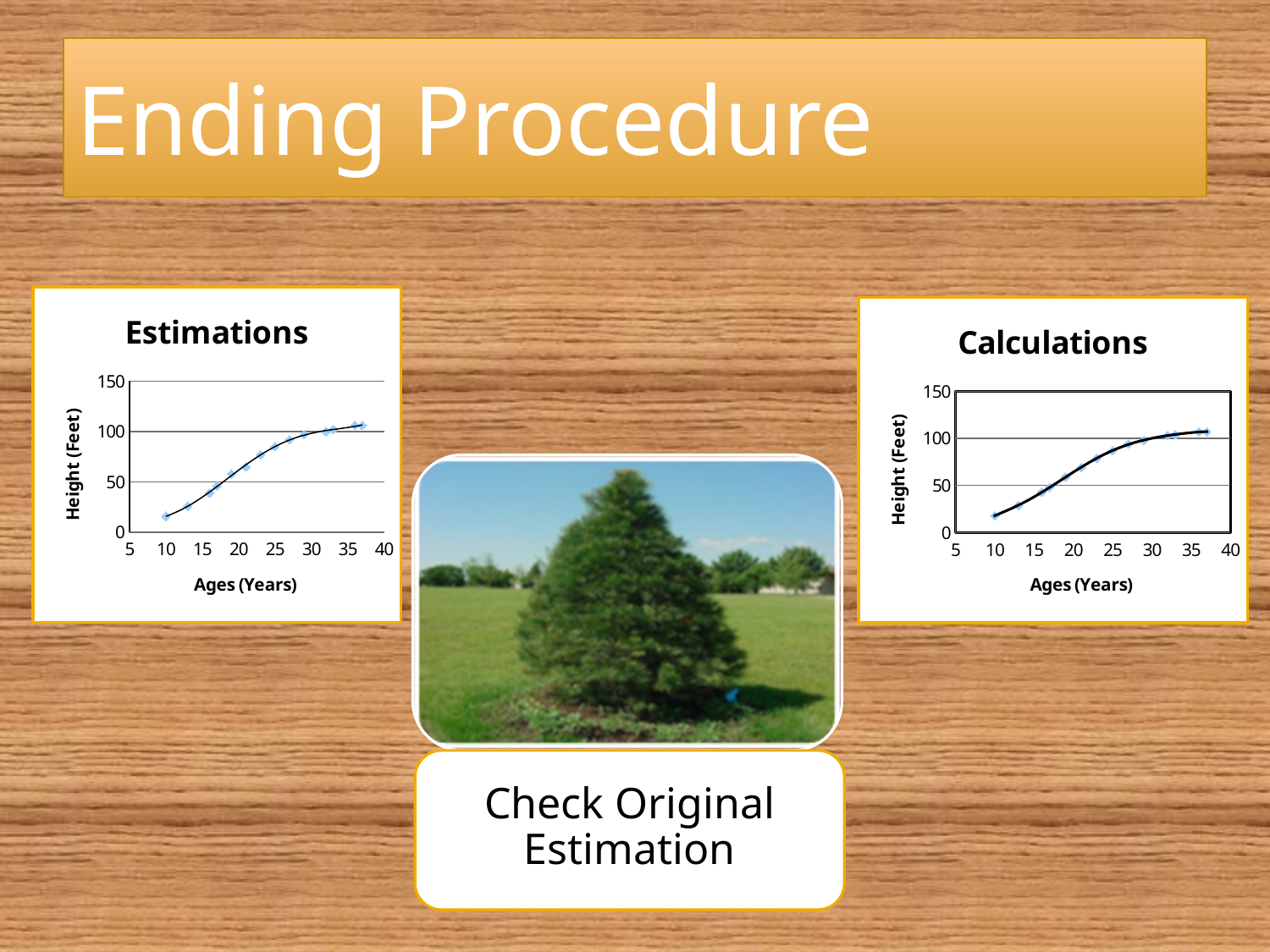
What kind of chart is the Estimations chart? scatter chart with a trend line In the Estimations chart, is the height at age 20 greater or less than 100? less In the Calculations chart, what is the title of the y axis? Height (Feet) In the Calculations chart, is the height at age 10 greater or less than 50? less In the Estimations chart, what is the title of the x axis? Ages (Years) In the Estimations chart, do the heights rise or fall as age increases? rise In the Estimations chart, is the height at age 10 greater or less than 50? less In the Calculations chart, do the heights rise or fall as age increases? rise What kind of chart is the Calculations chart? scatter chart with a trend line